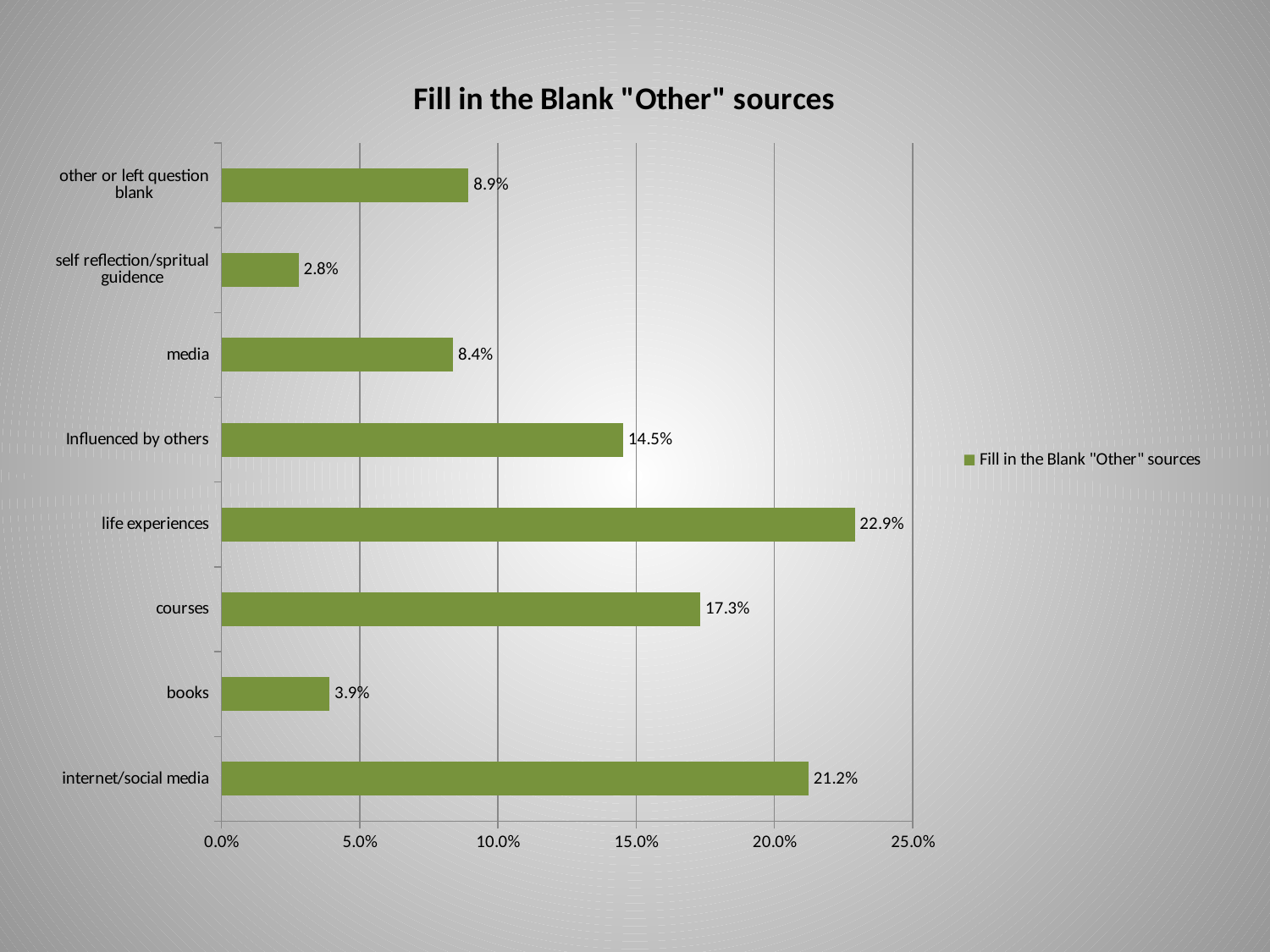
How many categories are shown in the chart? 8 What is the value for books? 3.9% Is the value for courses greater or less than 15.0%? greater Which is larger, the value for media or the value for books? media How many series does the legend list? 1 Which category has the lowest value? self reflection/spritual guidence What is the title of the chart? Fill in the Blank "Other" sources What kind of chart is shown on the slide? bar chart What is the difference between the values for courses and Influenced by others? 2.8% What is the value for internet/social media? 21.2% What is the value for life experiences? 22.9% Which category has the highest value? life experiences